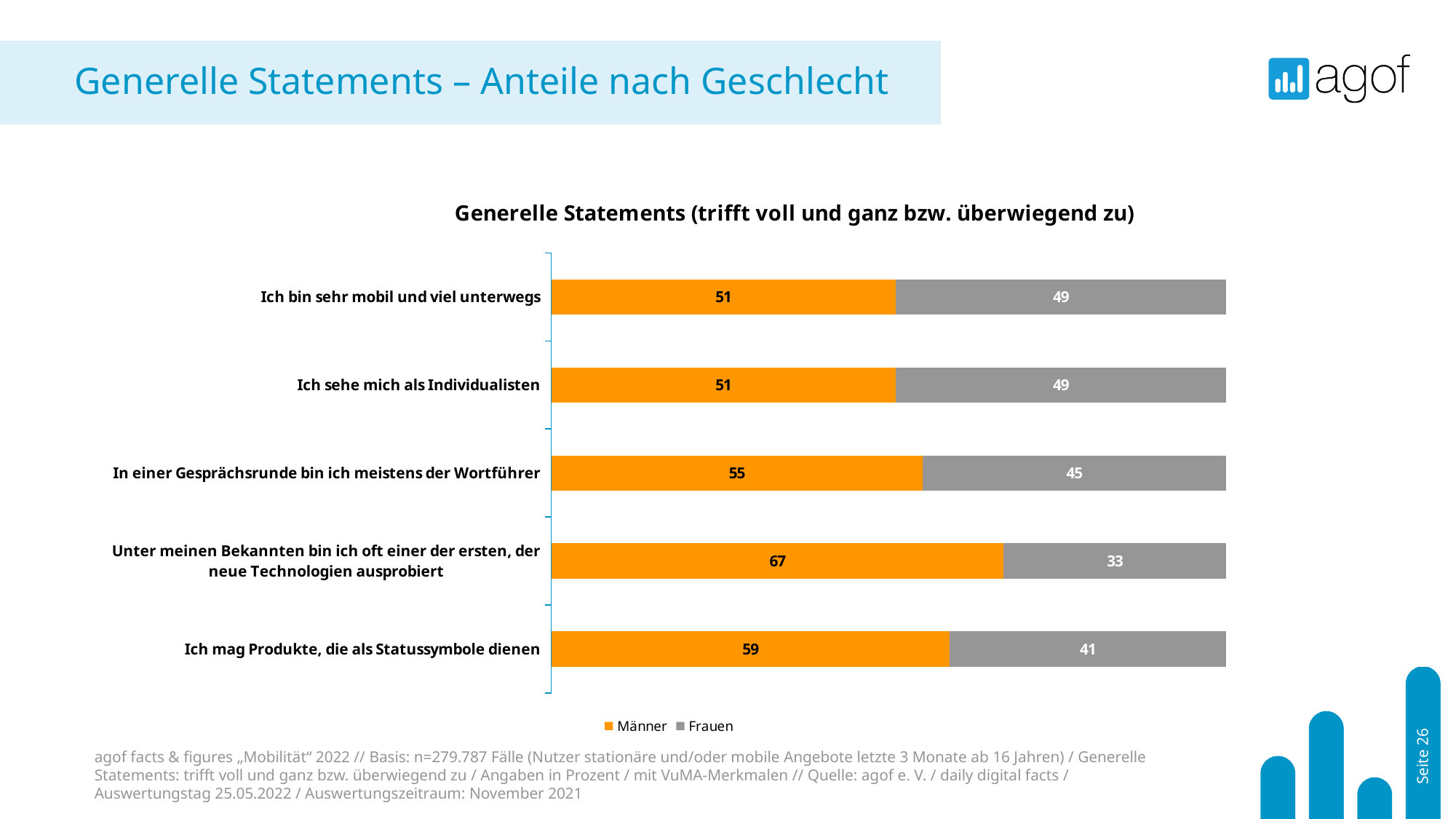
What is the Männer value for "Ich mag Produkte, die als Statussymbole dienen"? 59 What is the total of the stacked bar for "Ich bin sehr mobil und viel unterwegs"? 100 Which colour represents Frauen in the chart? Grey Which statement has the lowest Frauen share? Unter meinen Bekannten bin ich oft einer der ersten, der neue Technologien ausprobiert How many statements are shown in the chart? 5 What is the Männer value for "Unter meinen Bekannten bin ich oft einer der ersten, der neue Technologien ausprobiert"? 67 Which is larger for "In einer Gesprächsrunde bin ich meistens der Wortführer": the Männer value or the Frauen value? Männer Which statement has the highest Männer share? Unter meinen Bekannten bin ich oft einer der ersten, der neue Technologien ausprobiert What is the difference between the Männer and Frauen values for "Ich mag Produkte, die als Statussymbole dienen"? 18 What kind of chart is shown on the slide? Stacked bar chart How many series does the legend list? 2 What is the Frauen value for "In einer Gesprächsrunde bin ich meistens der Wortführer"? 45